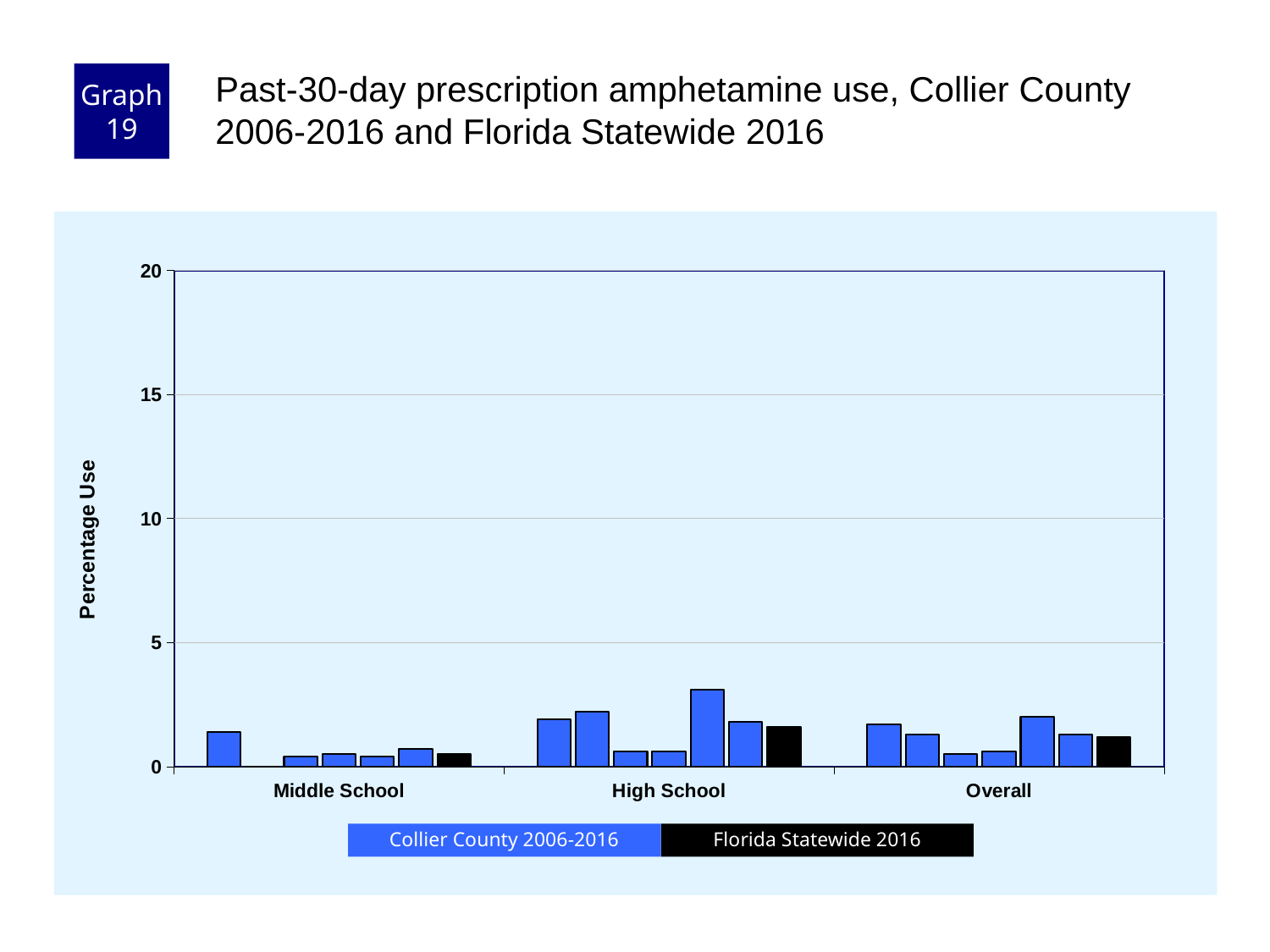
Is the Florida Statewide 2016 bar larger for High School or for Middle School? High School What kind of chart is shown on the slide? Bar chart Which series is shown in black in the legend? Florida Statewide 2016 Which category has the tallest Florida Statewide 2016 bar? High School Which category contains the tallest bar on the chart? High School Is the Florida Statewide 2016 bar larger for Overall or for Middle School? Overall Is the tallest bar in the High School category greater or less than 5? less Is the value for Florida Statewide 2016 in the High School category greater or less than 5? less How many categories are shown along the x axis? 3 Is the value for Florida Statewide 2016 in the Middle School category greater or less than 5? less How many series does the legend list? 2 What is the label of the y axis? Percentage Use